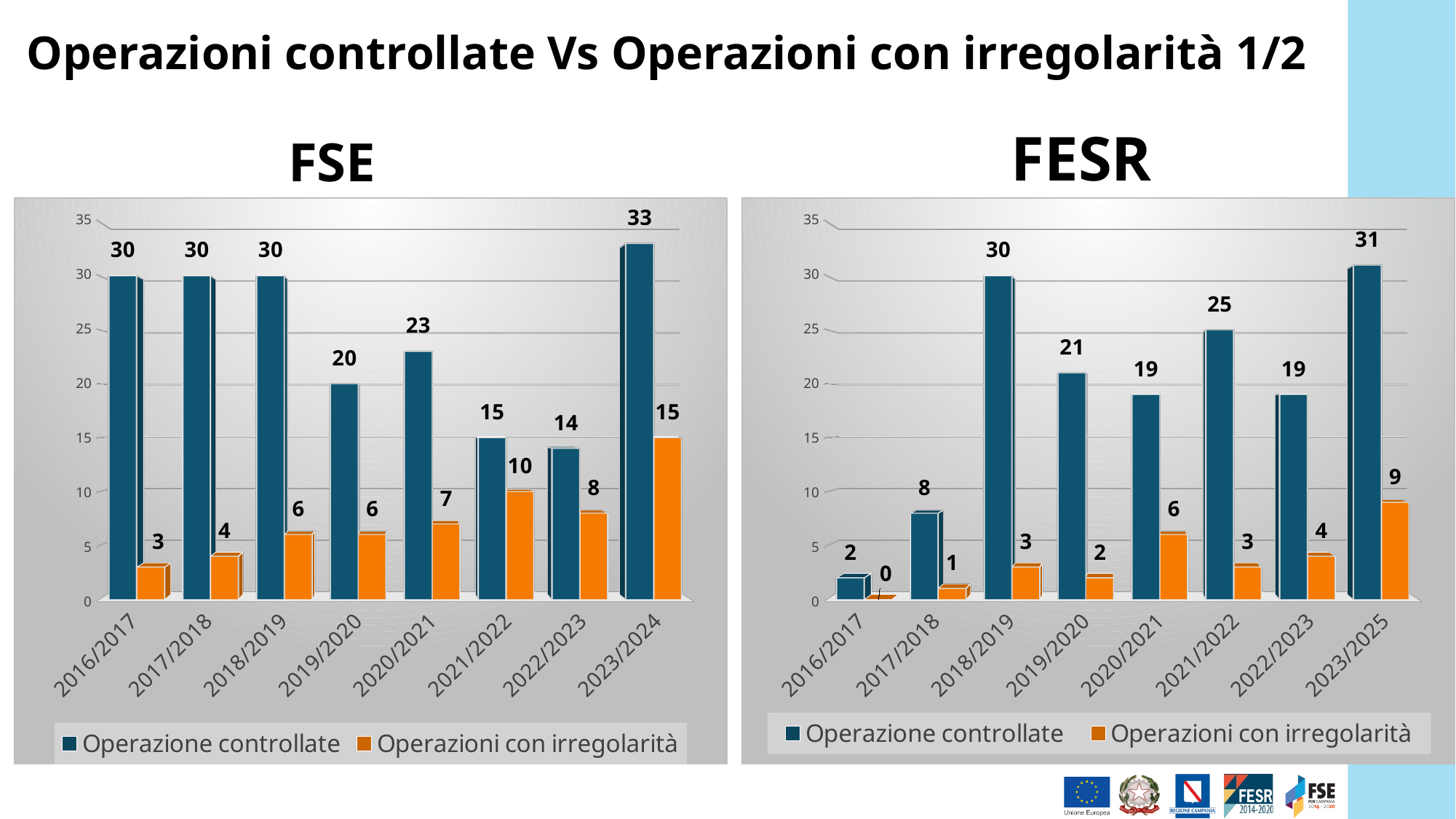
In the FSE chart, which category has the highest value for Operazione controllate? 2023/2024 How many series does the legend of the FESR chart list? 2 How many categories are shown on the x axis of the FSE chart? 8 In the FESR chart, what is the value of Operazioni con irregolarità for 2017/2018? 1 In the FESR chart, which category has the lowest value for Operazione controllate? 2016/2017 In the FSE chart, what is the difference between Operazione controllate and Operazioni con irregolarità for 2023/2024? 18 In the FSE chart, what is the value of Operazioni con irregolarità for 2021/2022? 10 What kind of chart is the FSE chart? Bar chart In the FESR chart, what is the value of Operazione controllate for 2021/2022? 25 In the FESR chart, which is larger: Operazioni con irregolarità for 2020/2021 or for 2022/2023? 2020/2021 In the FESR chart, what is the difference between Operazione controllate for 2018/2019 and 2019/2020? 9 In the FSE chart, what is the value of Operazione controllate for 2020/2021? 23